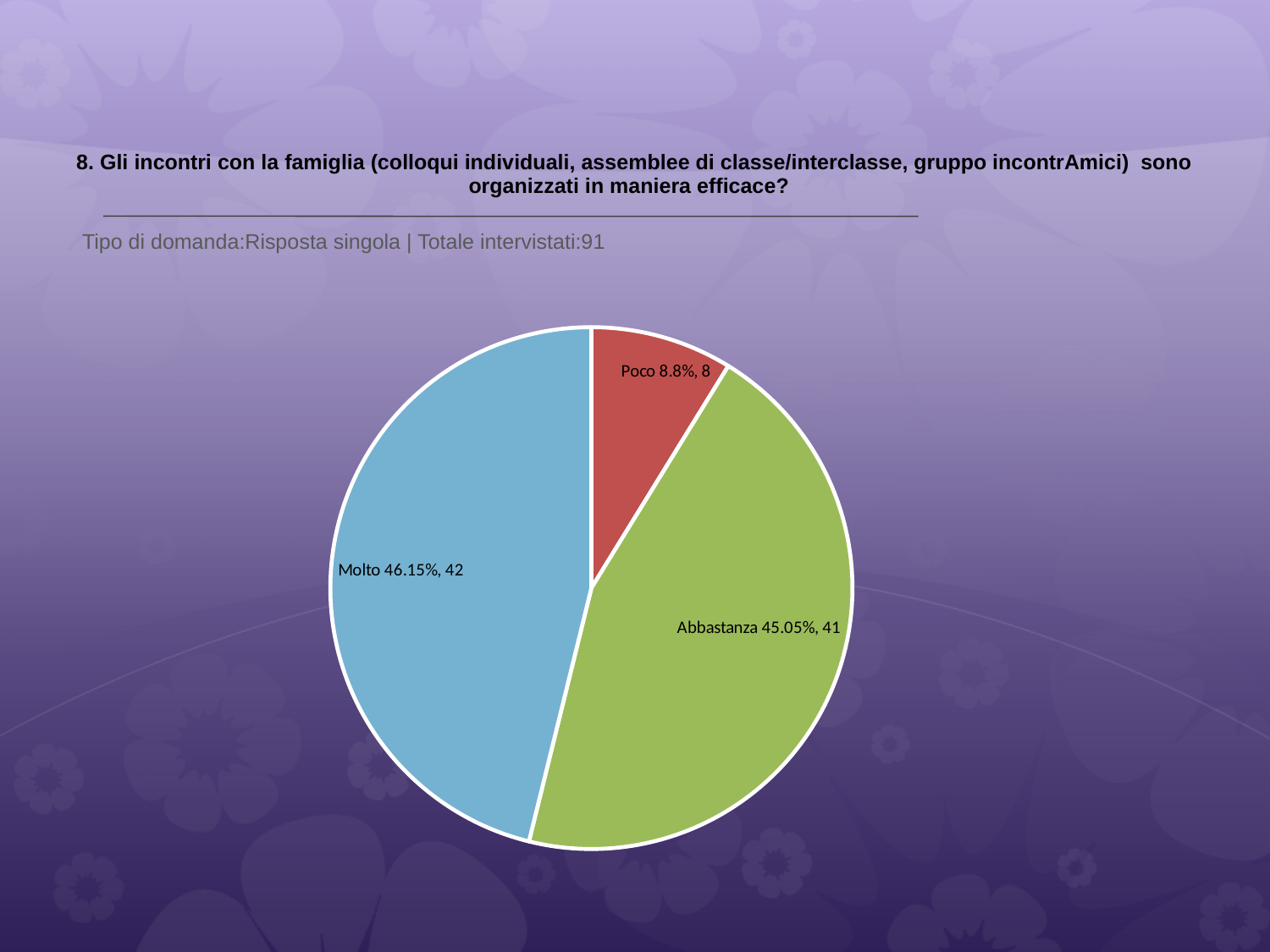
What percentage share does the Poco slice have? 8.8% How many respondents answered Molto? 42 How many respondents answered Abbastanza? 41 How many slices does the pie chart have? 3 What colour is the Poco slice? red What is the difference in respondent count between Molto and Poco? 34 What kind of chart is shown on the slide? pie chart Which category has the smallest slice? Poco What percentage share does the Abbastanza slice have? 45.05% How many respondents answered Poco? 8 What percentage share does the Molto slice have? 46.15% Which has more respondents, Abbastanza or Poco? Abbastanza